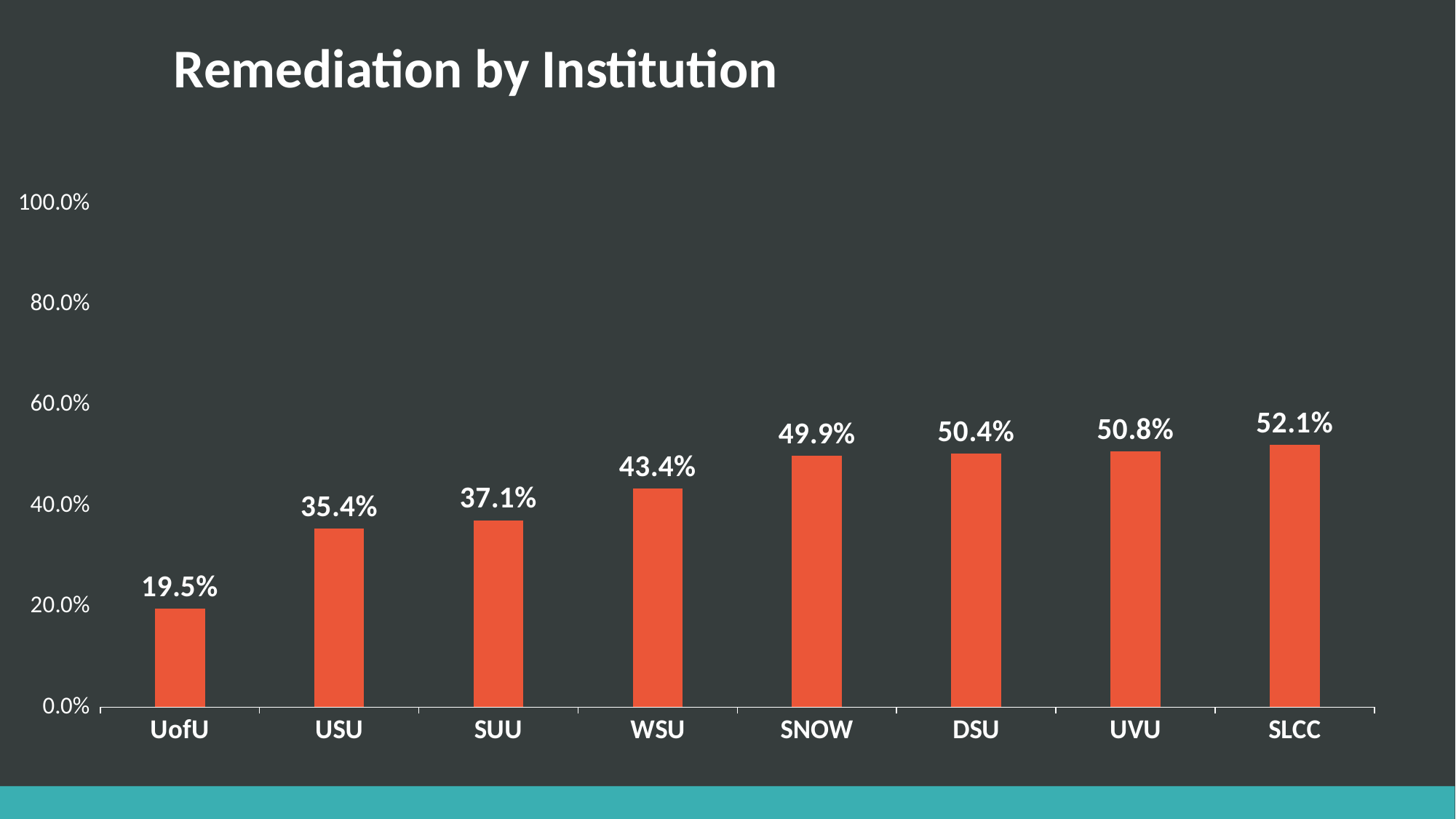
Is the value for USU greater or less than 40%? less Which institution has the highest remediation rate? SLCC What is the remediation rate for DSU? 50.4% How many institutions are shown on the chart? 8 What is the remediation rate for UofU? 19.5% What is the difference between the remediation rates of SLCC and UofU? 32.6% Do the values rise or fall from left to right across the institutions? Rise Which institution has the lowest remediation rate? UofU Which has a higher remediation rate, SUU or SNOW? SNOW What is the difference between the remediation rates of WSU and USU? 8.0% What kind of chart is shown on the slide? Bar chart What is the remediation rate for WSU? 43.4%